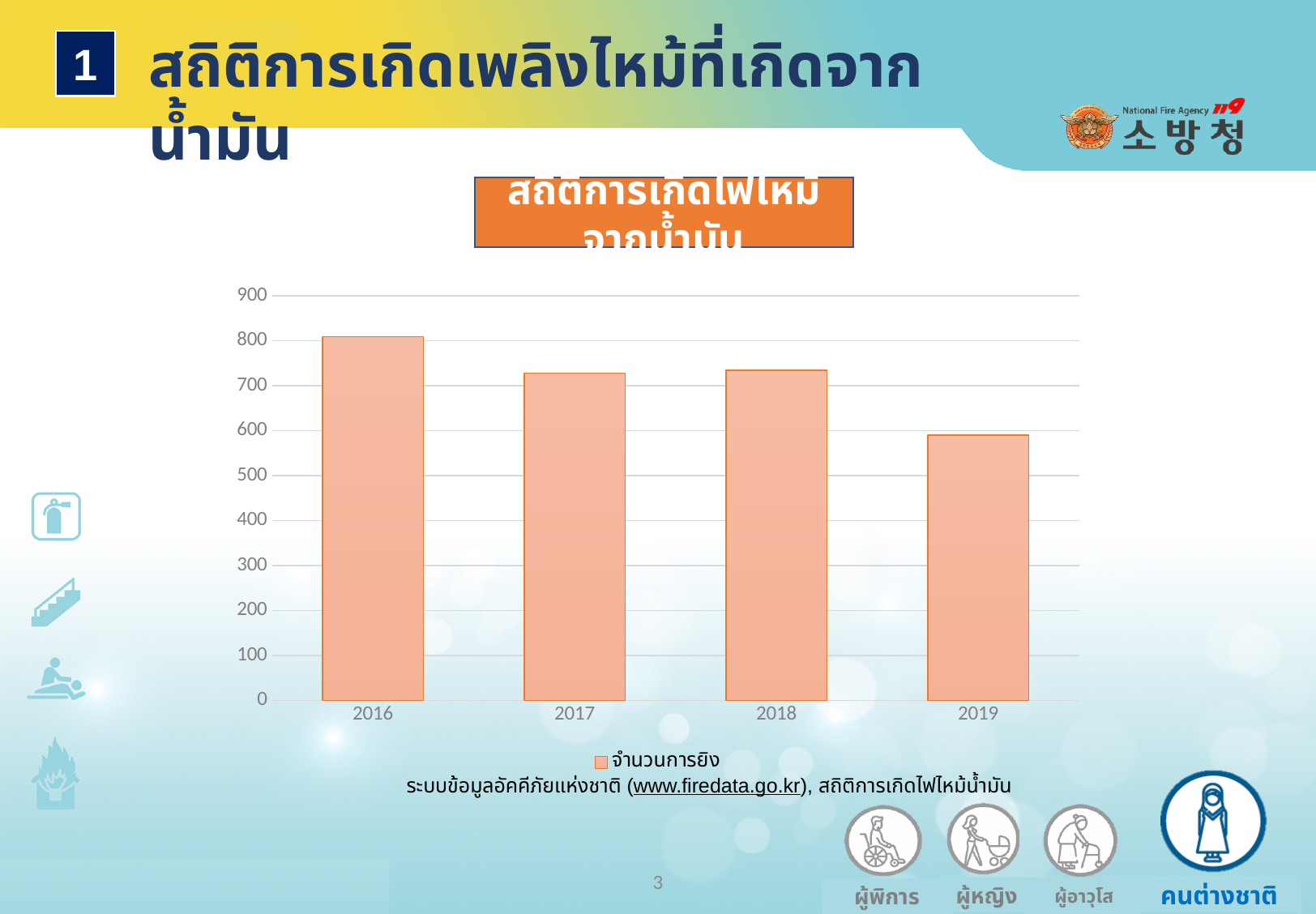
How many series does the chart legend list? 1 Which year has the highest bar in the chart? 2016 Is the value for 2018 greater or less than 700? greater How many years (categories) are shown on the x axis of the chart? 4 Overall, do the values rise or fall from 2016 to 2019? fall Is the value for 2017 greater or less than 800? less What kind of chart is shown on the slide? bar chart Which is larger, the value for 2016 or the value for 2019? 2016 Which year has the lowest bar in the chart? 2019 What is the legend entry shown below the chart? จำนวนการยิง Is the value for 2016 greater or less than 700? greater